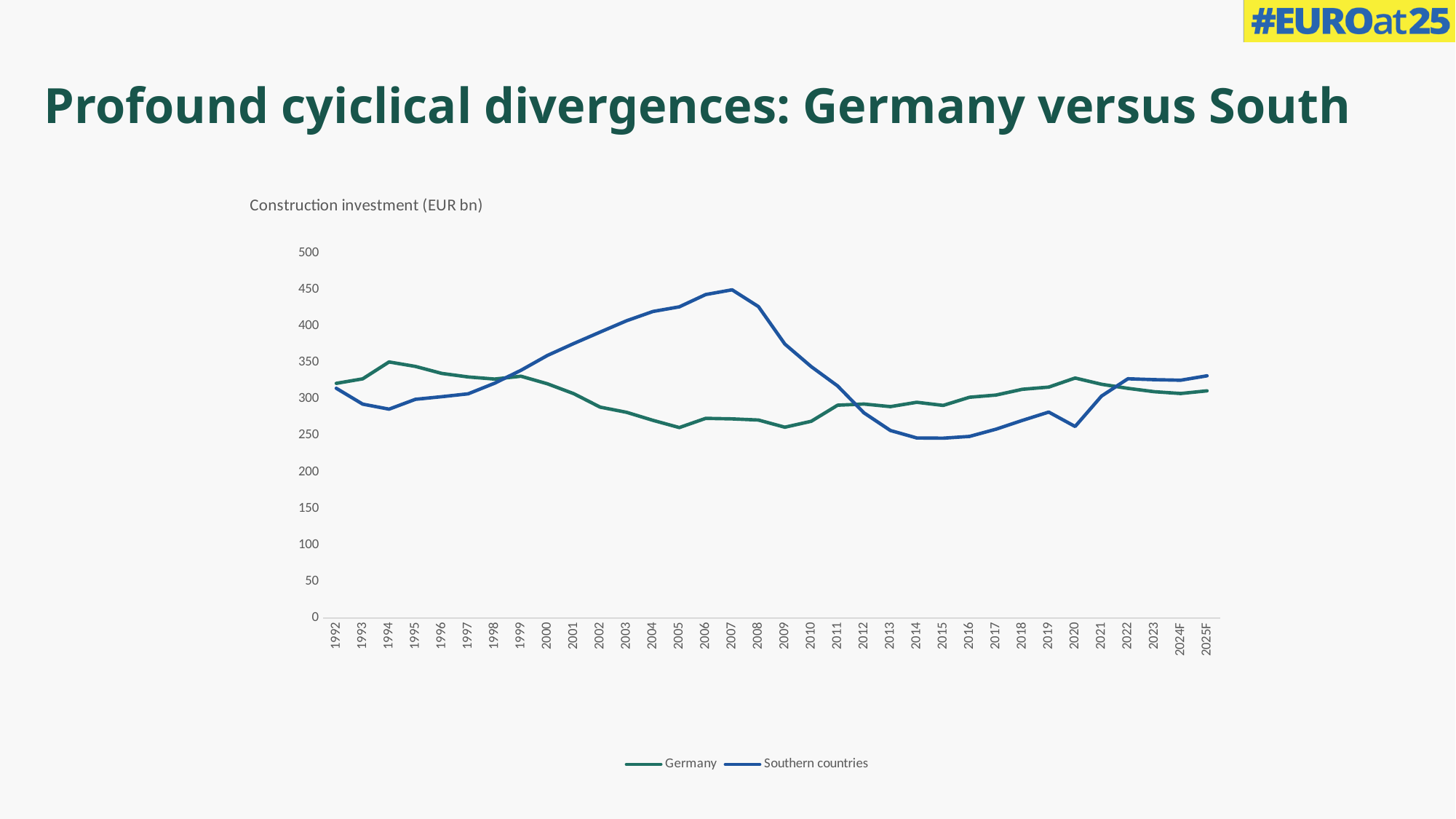
Is the value for Germany in 2005 greater or less than 300? less In 2014, which series has the larger value, Germany or Southern countries? Germany How many series does the legend list? 2 What kind of chart is shown on the slide? Line chart What is the title of the chart? Construction investment (EUR bn) In which year does the Germany line reach its highest value? 1994 How many years are shown along the x axis? 34 Is the value for Southern countries in 2014 greater or less than 300? less In which year does the Southern countries line reach its highest value? 2007 Does the Southern countries line rise or fall between 2007 and 2014? Fall In 2007, which series has the larger value, Germany or Southern countries? Southern countries Is the value for Southern countries in 2007 greater or less than 400? greater